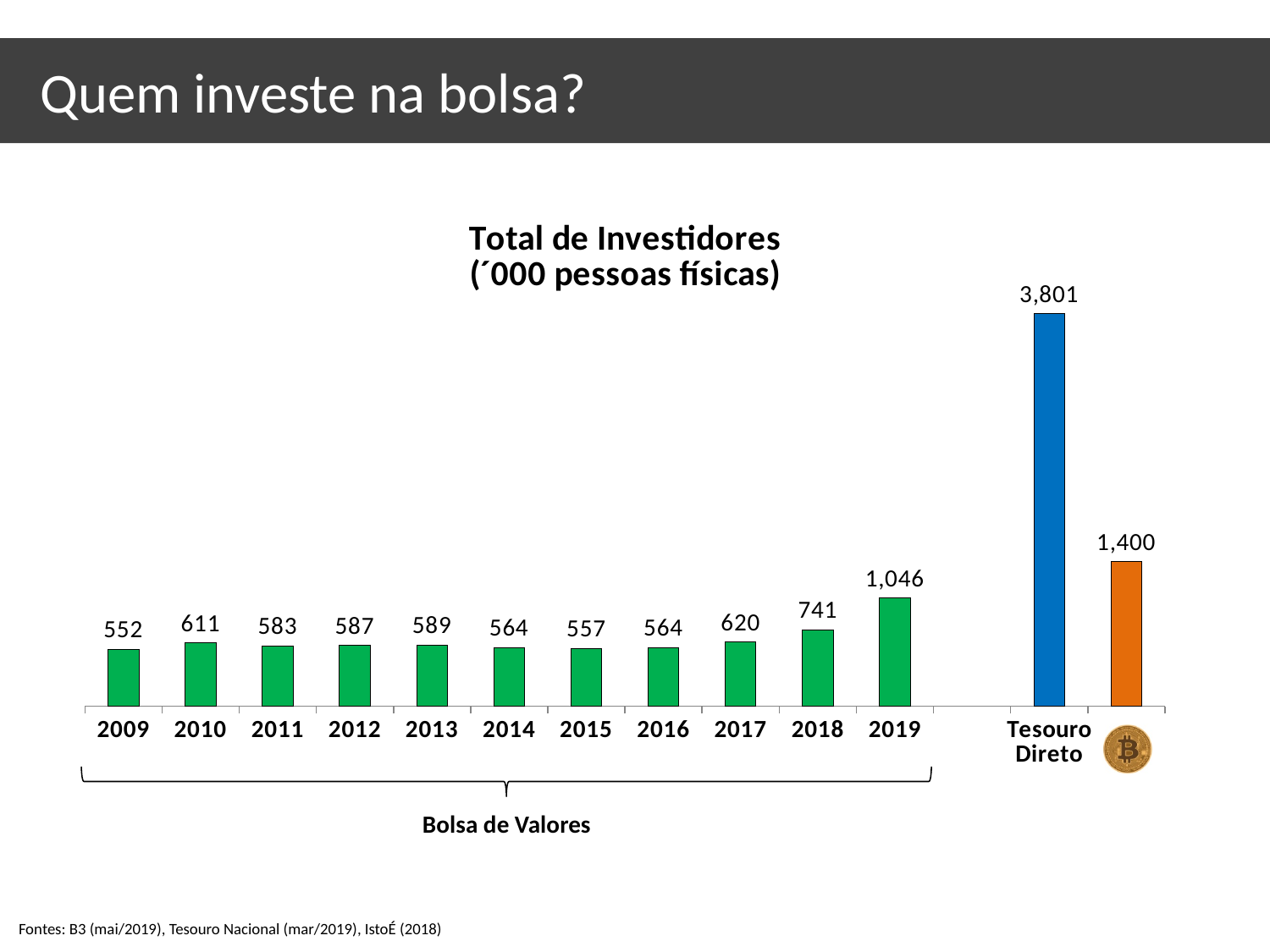
What is the difference between the Tesouro Direto value and the 2019 value in the Total de Investidores chart? 2,755 Which year from 2009 to 2019 has the lowest value in the Total de Investidores chart? 2009 How many years are grouped under Bolsa de Valores in the Total de Investidores chart? 11 What is the difference between the 2019 value and the 2018 value in the Total de Investidores chart? 305 Which is larger in the Total de Investidores chart, the value for 2010 or the value for 2011? 2010 What is the value for 2018 in the Total de Investidores chart? 741 What is the title of the chart on the slide? Total de Investidores (´000 pessoas físicas) What is the value for 2019 in the Total de Investidores chart? 1,046 What is the value for 2009 in the Total de Investidores chart? 552 What is the value for Tesouro Direto in the Total de Investidores chart? 3,801 Which category has the highest value in the Total de Investidores chart? Tesouro Direto What kind of chart is shown on the slide? Bar chart